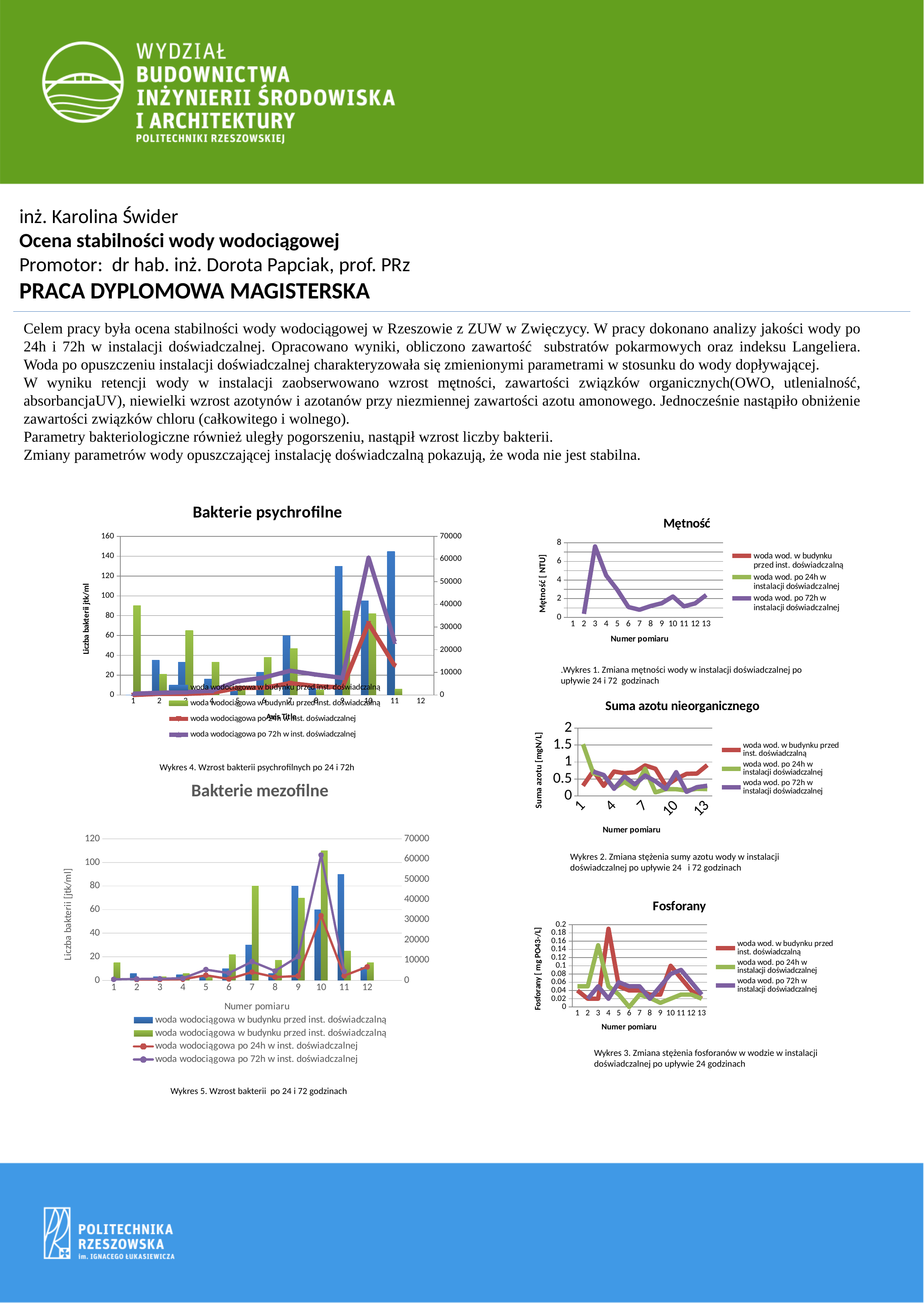
In the 'Mętność' chart, is the value at measurement number 3 greater or less than 6? greater In the 'Bakterie psychrofilne' chart, at which measurement number is the blue bar the tallest? 11 In the 'Suma azotu nieorganicznego' chart, is the value of the 'woda wod. po 24h w instalacji doświadczalnej' series at measurement number 1 greater or less than 1? greater What kind of chart is the 'Mętność' chart? line chart How many measurement numbers are shown on the x axis of the 'Fosforany' chart? 13 In the 'Mętność' chart, which measurement number has the highest turbidity value? 3 In the 'Fosforany' chart, at which measurement number does the 'woda wod. w budynku przed inst. doświadczalną' series reach its highest value? 4 In the 'Bakterie psychrofilne' chart, is the blue bar at measurement number 9 greater or less than 120 on the left axis? greater How many series does the legend of the 'Bakterie mezofilne' chart list? 4 How many series does the legend of the 'Mętność' chart list? 3